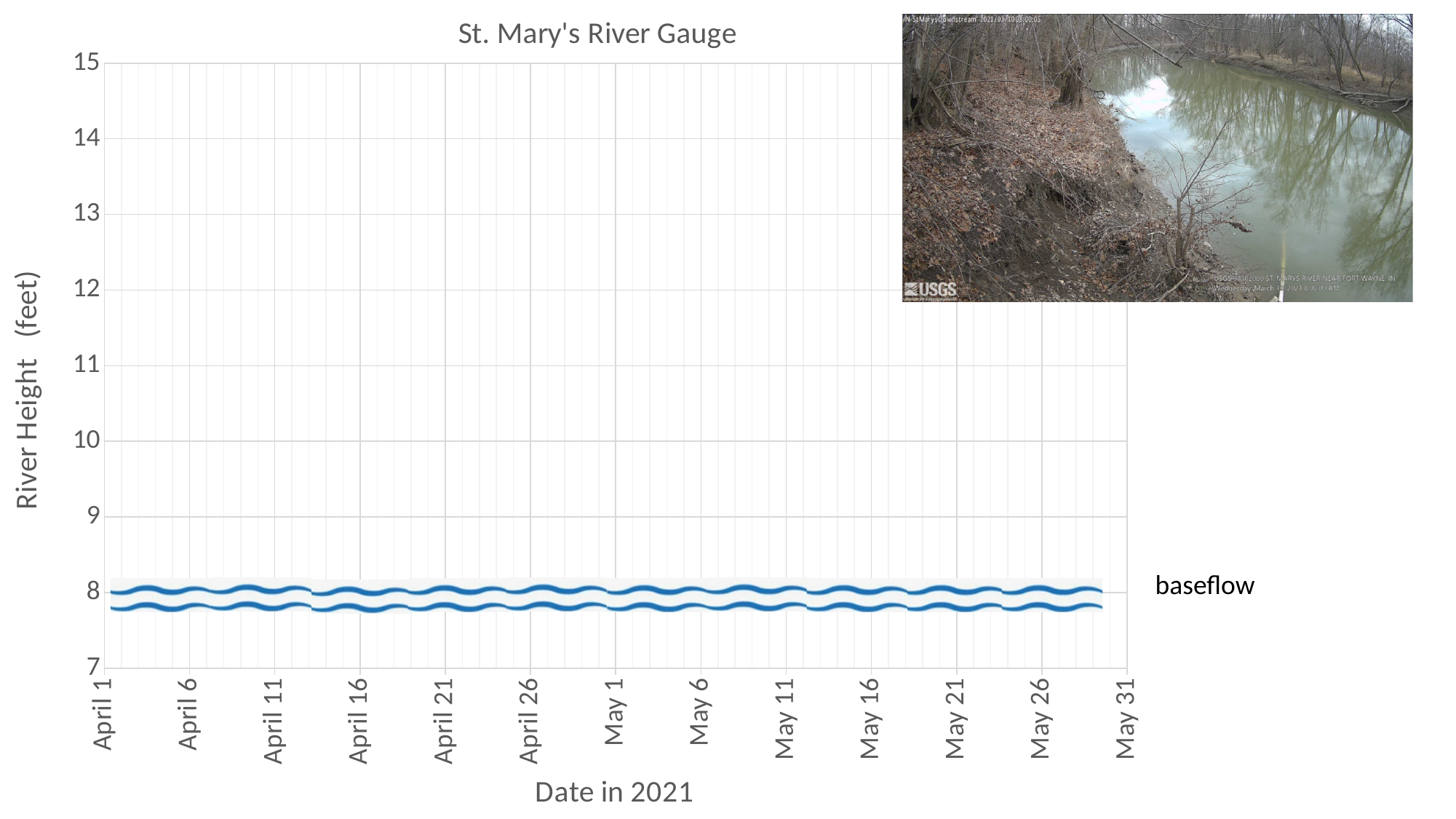
What is the title of the chart? St. Mary's River Gauge What label is written next to the plotted line on the right side of the chart? baseflow Is the river height on April 6 greater or less than 12 feet? less Is the river height on May 26 greater or less than 10 feet? less Is the river height on April 16 greater or less than 9 feet? less What kind of chart is shown on the slide? line chart Does the river height rise, fall, or stay roughly the same from April 1 to May 31? stays roughly the same What is the highest value shown on the y axis? 15 How many date labels are shown along the x axis? 13 What is the lowest value shown on the y axis? 7